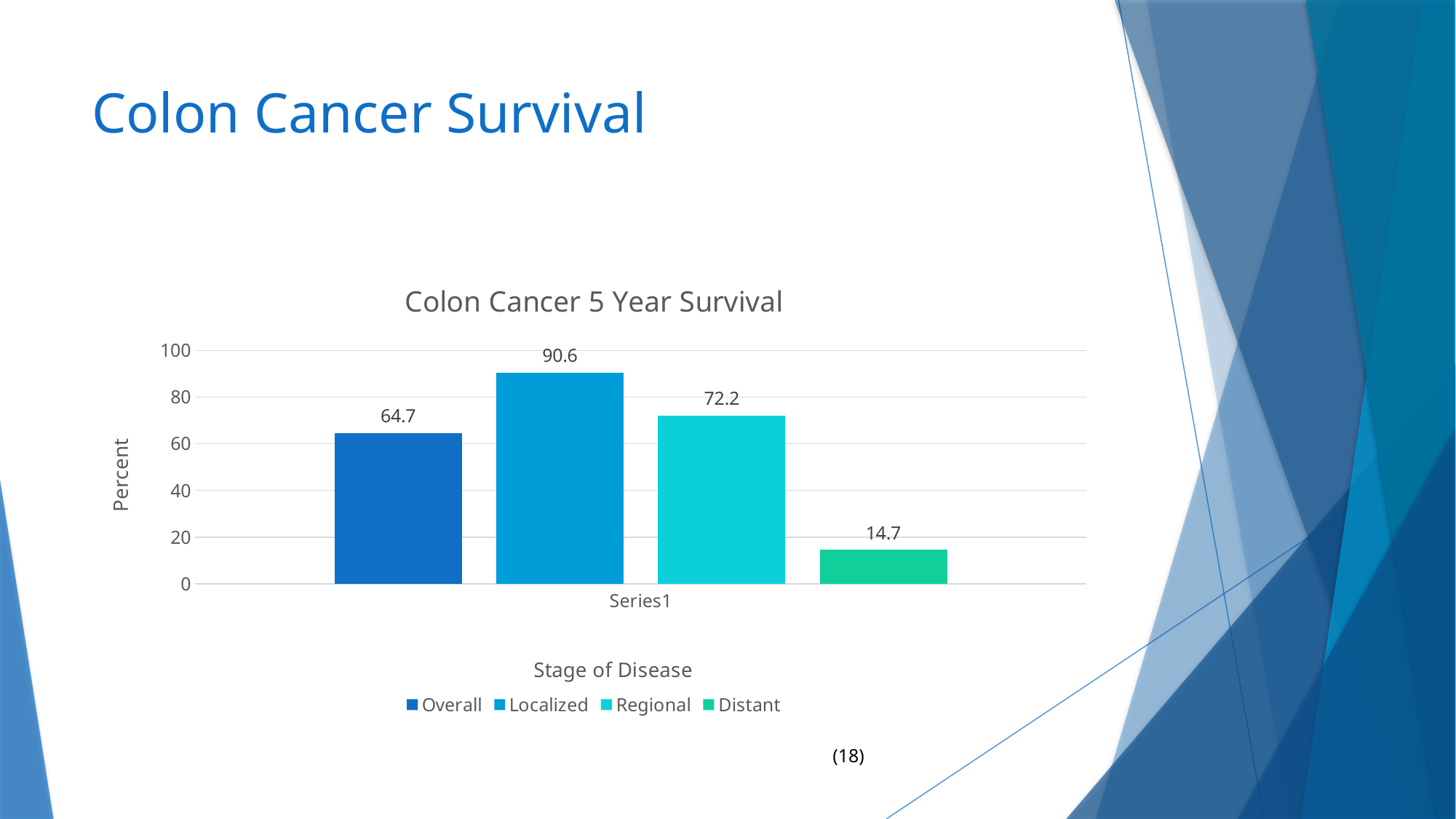
What is the value shown for Distant? 14.7 What is the difference between the Localized and Regional values? 18.4 What kind of chart is shown? Bar chart What is the label on the vertical axis? Percent What is the value shown for Overall? 64.7 What is the title of the chart? Colon Cancer 5 Year Survival Which series has the lowest value? Distant How many series does the legend list? 4 Is the value for Distant greater or less than 20? less Which is larger, the value for Regional or the value for Overall? Regional Which series has the highest value? Localized What is the 5-year survival value for Localized? 90.6